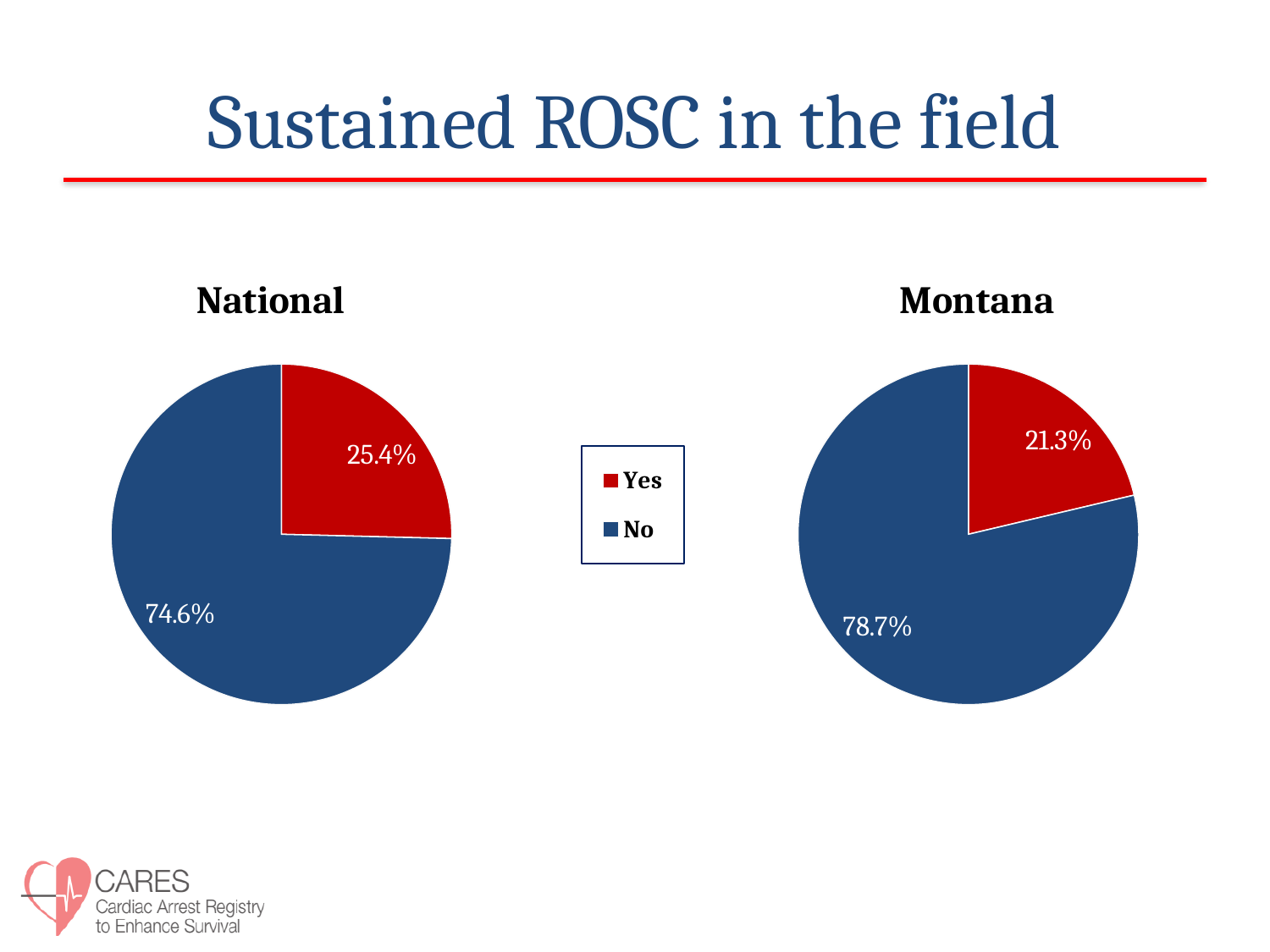
How many slices does the Montana pie chart have? 2 In the Montana pie chart, what percentage is labelled for the Yes slice? 21.3% How many entries does the legend list? 2 What colour represents the Yes category in the legend? Red What is the difference between the Yes share in the National chart and the Yes share in the Montana chart? 4.1% In the National pie chart, what percentage is labelled for the Yes slice? 25.4% In the National pie chart, which slice is the smallest? Yes In the Montana pie chart, what percentage is labelled for the No slice? 78.7% What kind of chart is used for the National data? Pie chart In the National pie chart, what percentage is labelled for the No slice? 74.6% Which chart has the larger Yes share, National or Montana? National In the Montana pie chart, which slice is the largest? No